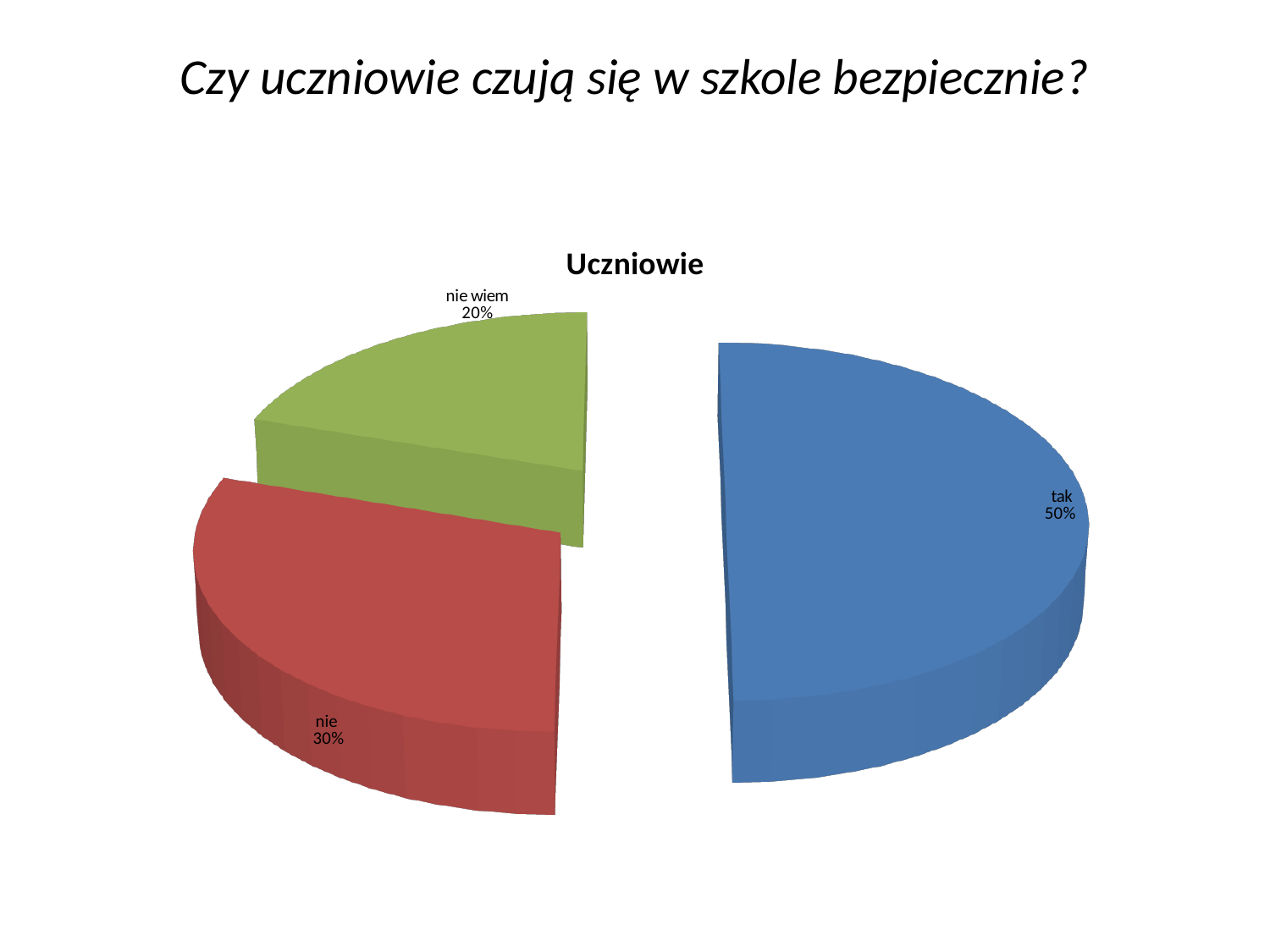
What share of the pie does the "nie wiem" slice represent? 20% What is the difference in percentage points between the "tak" and "nie" slices? 20% What is the difference in percentage points between the "nie" and "nie wiem" slices? 10% What is the title of the chart? Uczniowie What kind of chart is shown on the slide? pie chart What colour is the "tak" slice? blue Which category has the smallest slice of the pie? nie wiem Which category has the largest slice of the pie? tak What share of the pie does the "tak" slice represent? 50% What share of the pie does the "nie" slice represent? 30% Which is larger, the "nie" slice or the "nie wiem" slice? nie How many slices does the pie chart have? 3